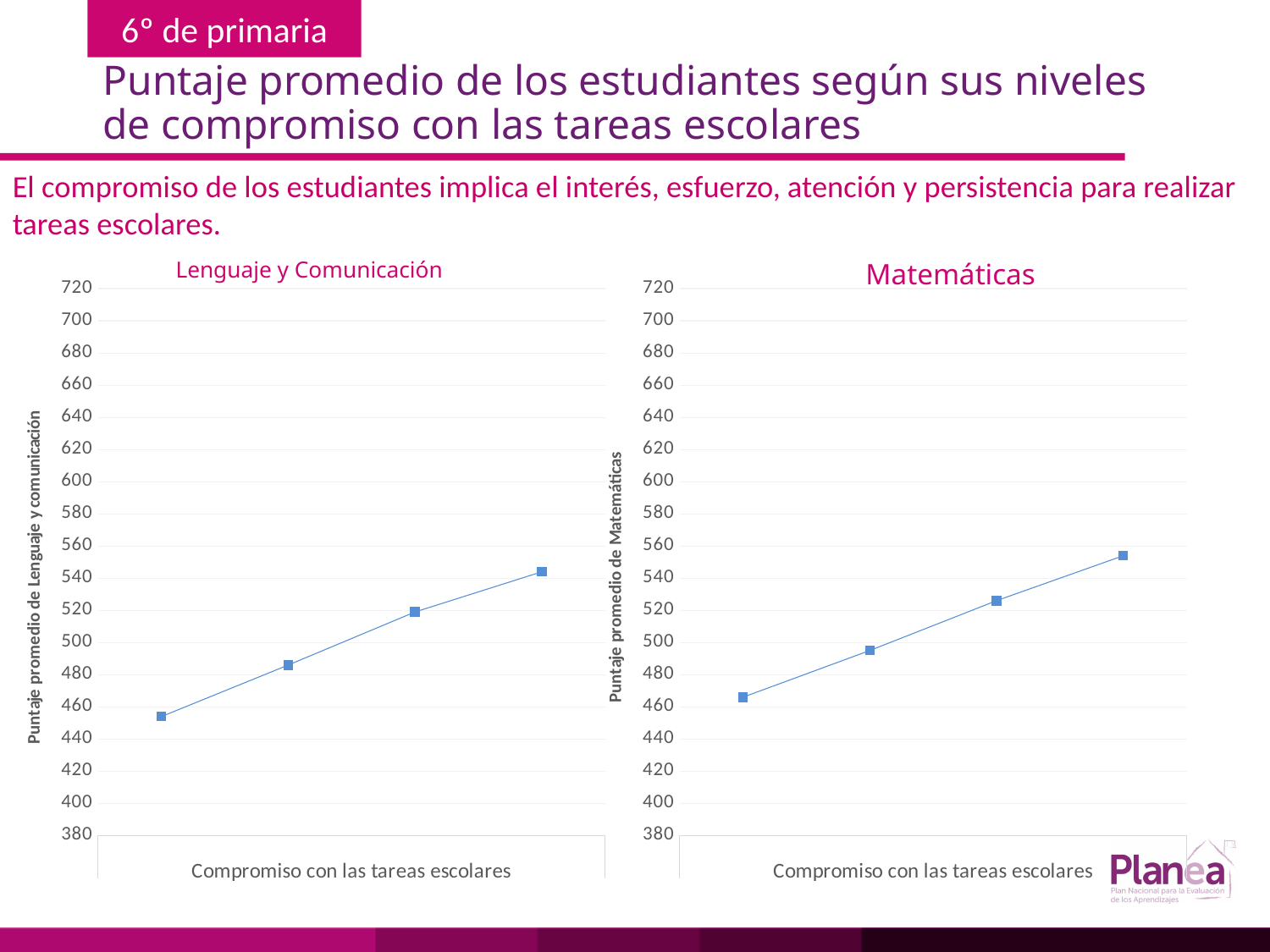
What is the x-axis title of the 'Matemáticas' chart? Compromiso con las tareas escolares In the 'Lenguaje y Comunicación' chart, is the value of the leftmost point greater or less than 460? less In the 'Lenguaje y Comunicación' chart, is the value of the rightmost point greater or less than 540? greater In the 'Matemáticas' chart, is the value of the leftmost point greater or less than 460? greater What kind of chart is the 'Lenguaje y Comunicación' chart? line chart In the 'Lenguaje y Comunicación' chart, do the values rise or fall from left to right along the x axis? rise How many data points are plotted in the 'Matemáticas' chart? 4 In the 'Matemáticas' chart, do the values rise or fall from left to right along the x axis? rise How many data points are plotted in the 'Lenguaje y Comunicación' chart? 4 In the 'Matemáticas' chart, which point has the higher value, the leftmost or the rightmost? the rightmost What kind of chart is the 'Matemáticas' chart? line chart